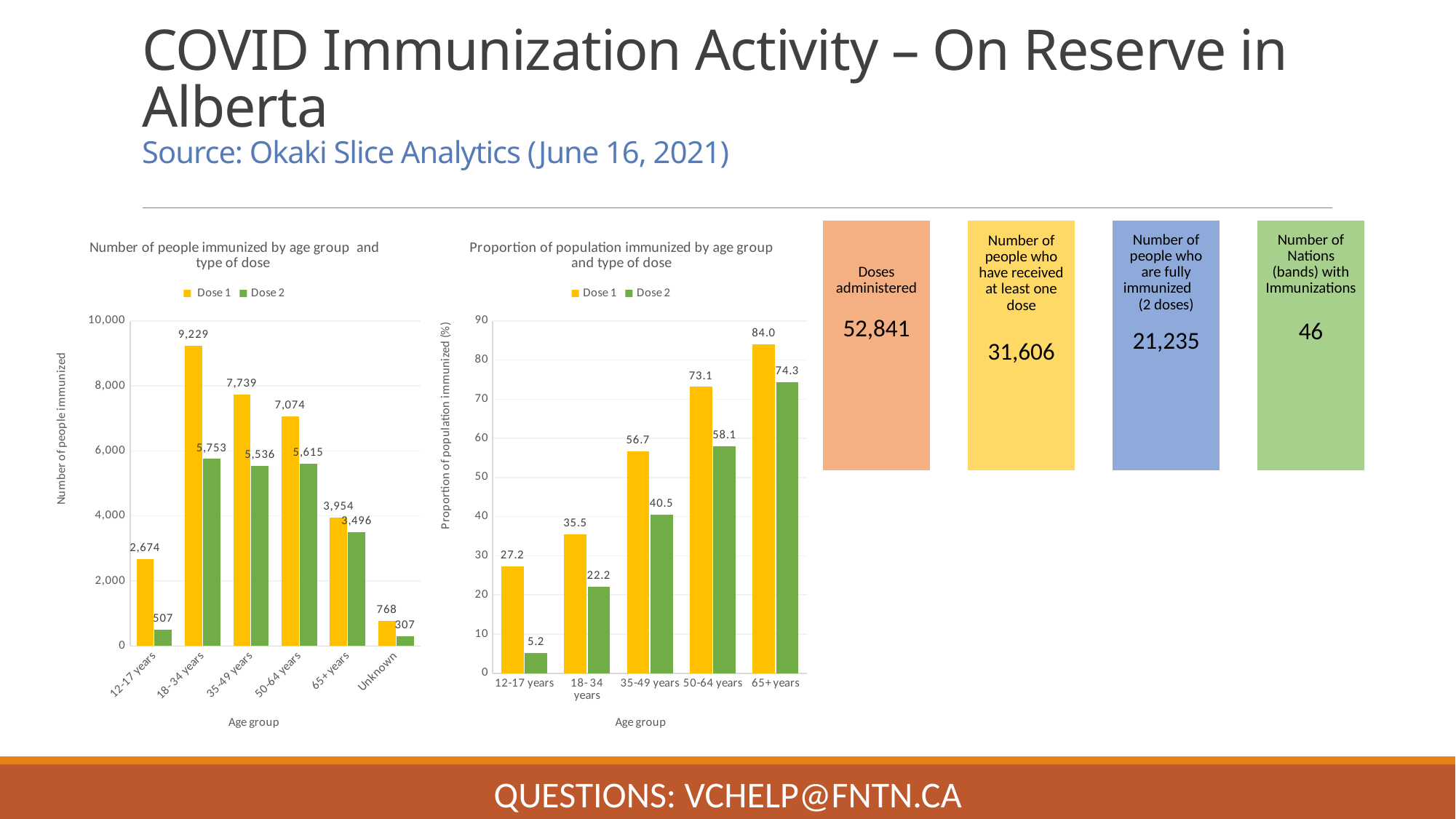
In the 'Number of people immunized by age group and type of dose' chart, what is the Dose 1 value for 18-34 years? 9,229 How many series does the legend list in the 'Proportion of population immunized by age group and type of dose' chart? 2 What kind of chart is the 'Number of people immunized by age group and type of dose' chart? bar chart In the 'Proportion of population immunized by age group and type of dose' chart, do the Dose 1 values rise or fall from 12-17 years to 65+ years? rise In the 'Number of people immunized by age group and type of dose' chart, which age group has the highest Dose 1 value? 18-34 years In the 'Proportion of population immunized by age group and type of dose' chart, what is the Dose 1 value for 12-17 years? 27.2 How many age group categories are shown in the 'Number of people immunized by age group and type of dose' chart? 6 In the 'Number of people immunized by age group and type of dose' chart, which age group has the lowest Dose 2 value? Unknown In the 'Number of people immunized by age group and type of dose' chart, what is the Dose 2 value for 65+ years? 3,496 In the 'Number of people immunized by age group and type of dose' chart, what is the difference between Dose 1 and Dose 2 for 35-49 years? 2,203 In the 'Proportion of population immunized by age group and type of dose' chart, which age group has the highest Dose 1 value? 65+ years In the 'Proportion of population immunized by age group and type of dose' chart, what is the Dose 2 value for 50-64 years? 58.1